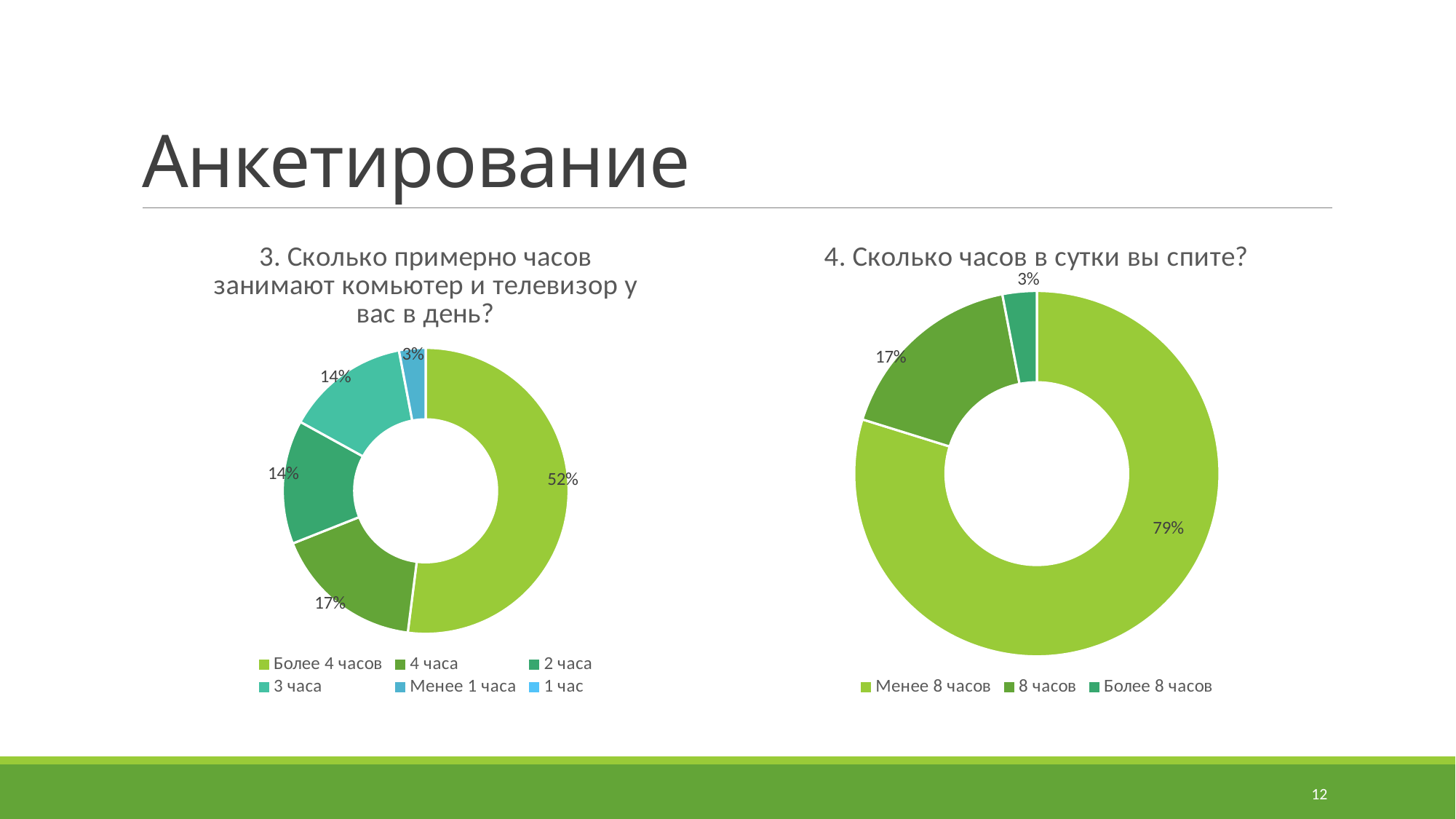
On the chart titled "4. Сколько часов в сутки вы спите?", which is larger: the share for "8 часов" or for "Более 8 часов"? 8 часов On the chart titled "3. Сколько примерно часов занимают компьютер и телевизор у вас в день?", which category has the largest share? Более 4 часов On the chart titled "3. Сколько примерно часов занимают компьютер и телевизор у вас в день?", what share is shown for "Более 4 часов"? 52% On the chart titled "4. Сколько часов в сутки вы спите?", which category has the smallest share? Более 8 часов On the chart titled "4. Сколько часов в сутки вы спите?", what share is shown for "Менее 8 часов"? 79% On the chart titled "4. Сколько часов в сутки вы спите?", what share is shown for "8 часов"? 17% On the chart titled "3. Сколько примерно часов занимают компьютер и телевизор у вас в день?", what share is shown for "Менее 1 часа"? 3% On the chart titled "3. Сколько примерно часов занимают компьютер и телевизор у вас в день?", how many entries does the legend list? 6 On the chart titled "4. Сколько часов в сутки вы спите?", how many categories does the legend list? 3 What type of chart is used for "4. Сколько часов в сутки вы спите?"? Doughnut (pie) chart On the chart titled "3. Сколько примерно часов занимают компьютер и телевизор у вас в день?", what share is shown for "4 часа"? 17% On the chart titled "3. Сколько примерно часов занимают компьютер и телевизор у вас в день?", what is the difference in percentage points between "Более 4 часов" and "4 часа"? 35